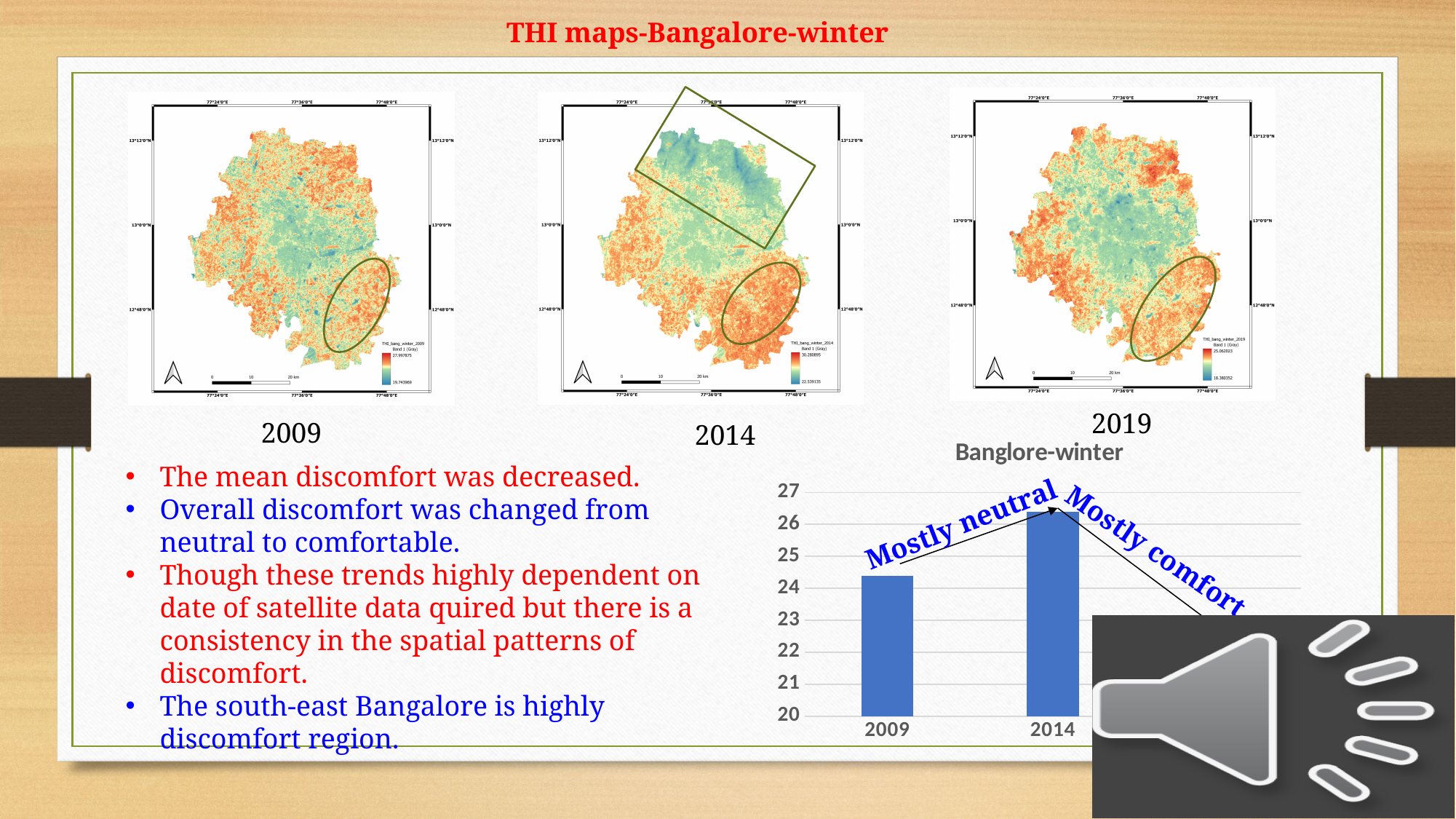
In the "Banglore-winter" chart, is the value for 2014 greater or less than 27? less In the "Banglore-winter" chart, is the value for 2009 greater or less than 24? greater In the "Banglore-winter" chart, which is larger, the value for 2009 or the value for 2014? 2014 What is the lowest value shown on the y axis of the "Banglore-winter" chart? 20 What kind of chart is the "Banglore-winter" chart? bar chart In the "Banglore-winter" chart, does the value rise or fall from 2009 to 2014? rise What is the title of the bar chart on the slide? Banglore-winter In the "Banglore-winter" chart, is the value for 2009 greater or less than 25? less